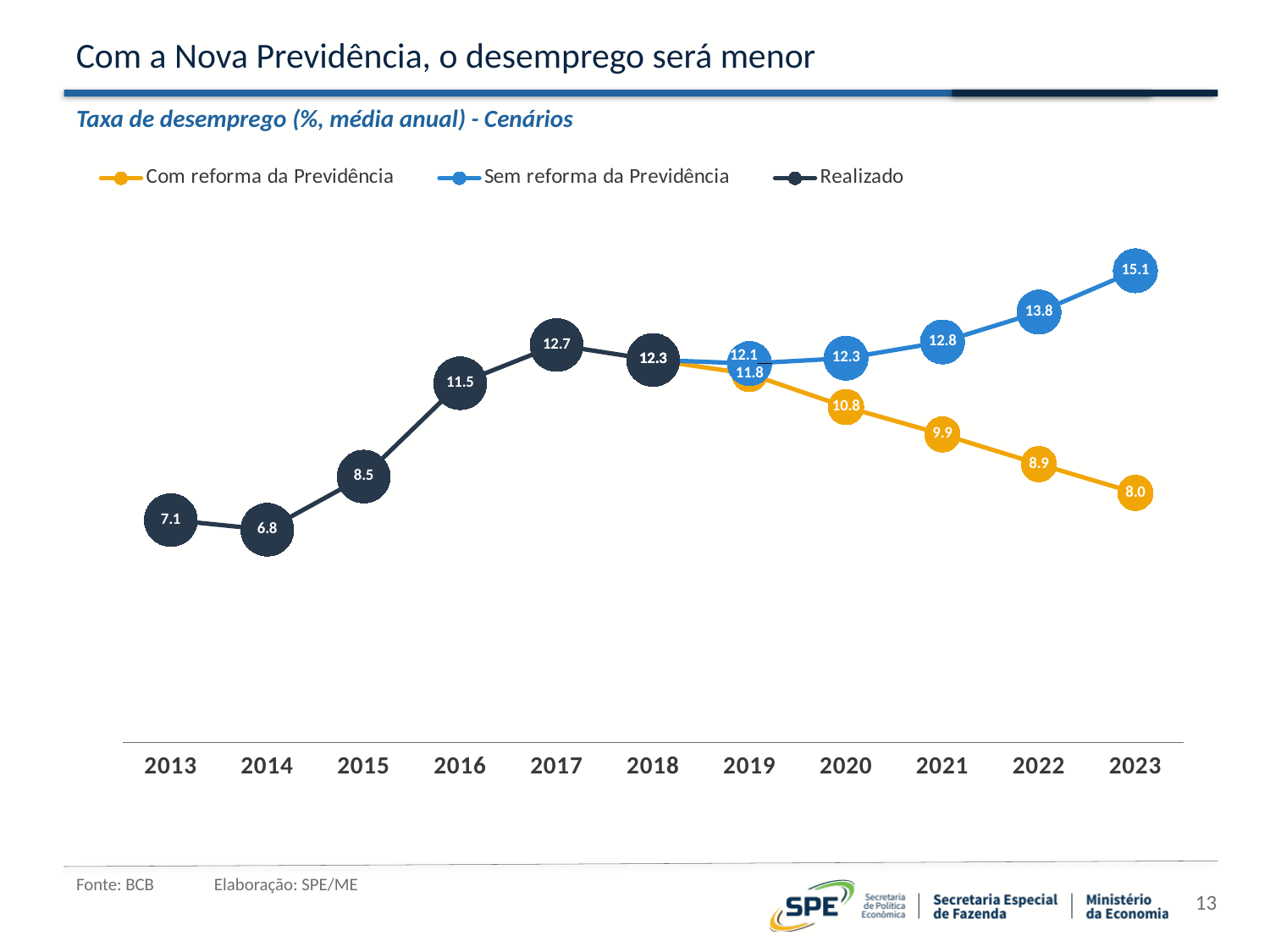
What is the difference between the Sem reforma da Previdência and Com reforma da Previdência values in 2023? 7.1 How many series does the legend list? 3 What is the value of the Com reforma da Previdência series in 2021? 9.9 Does the Com reforma da Previdência series rise or fall from 2019 to 2023? fall What is the value of the Realizado series in 2017? 12.7 In which year does the Realizado series reach its lowest value? 2014 In which year does the Sem reforma da Previdência series reach its highest value? 2023 What is the value of the Sem reforma da Previdência series in 2023? 15.1 How many years are shown on the x axis? 11 What kind of chart is shown on the slide? line chart Which series has the larger value in 2020, Com reforma da Previdência or Sem reforma da Previdência? Sem reforma da Previdência What is the title of the chart? Taxa de desemprego (%, média anual) - Cenários